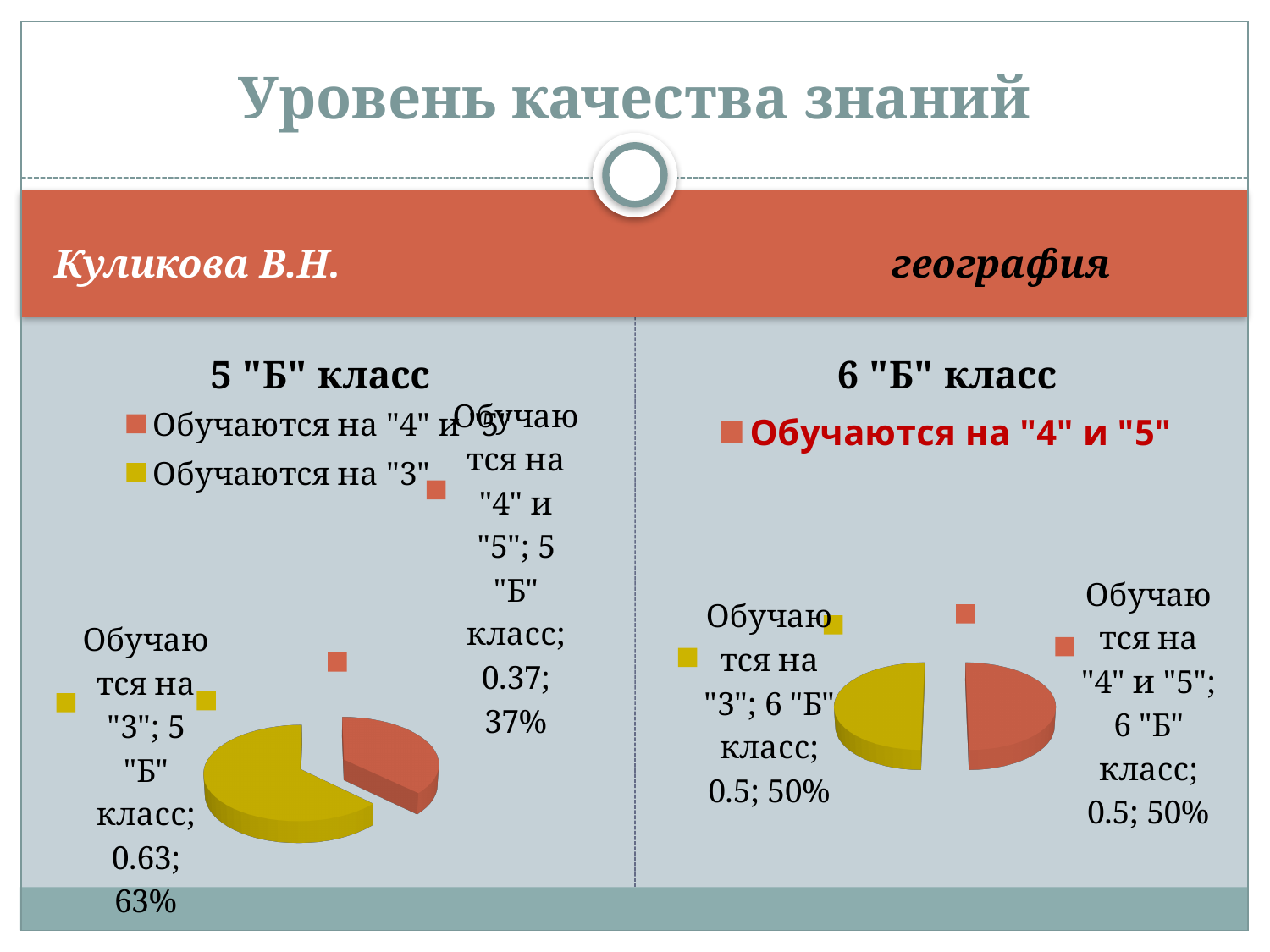
In the "5 "Б" класс" chart, what share of the pie is "Обучаются на "3""? 63% In the "5 "Б" класс" chart, which slice is the largest? Обучаются на "3" In the "5 "Б" класс" chart, how many entries does the legend list? 2 In the "6 "Б" класс" chart, what share of the pie is "Обучаются на "4" и "5""? 50% In the "6 "Б" класс" chart, what value is printed for "Обучаются на "3""? 0.5 How many slices does the "6 "Б" класс" pie chart have? 2 In the "5 "Б" класс" chart, what value is printed for "Обучаются на "3""? 0.63 In the "5 "Б" класс" chart, what is the difference in percentage points between the "Обучаются на "3"" slice and the "Обучаются на "4" и "5"" slice? 26% In the "5 "Б" класс" chart, what share of the pie is "Обучаются на "4" и "5""? 37% In the "5 "Б" класс" chart, what colour is the "Обучаются на "3"" slice? yellow In the "5 "Б" класс" chart, which slice is the smallest? Обучаются на "4" и "5" What kind of chart is the "5 "Б" класс" chart? pie chart